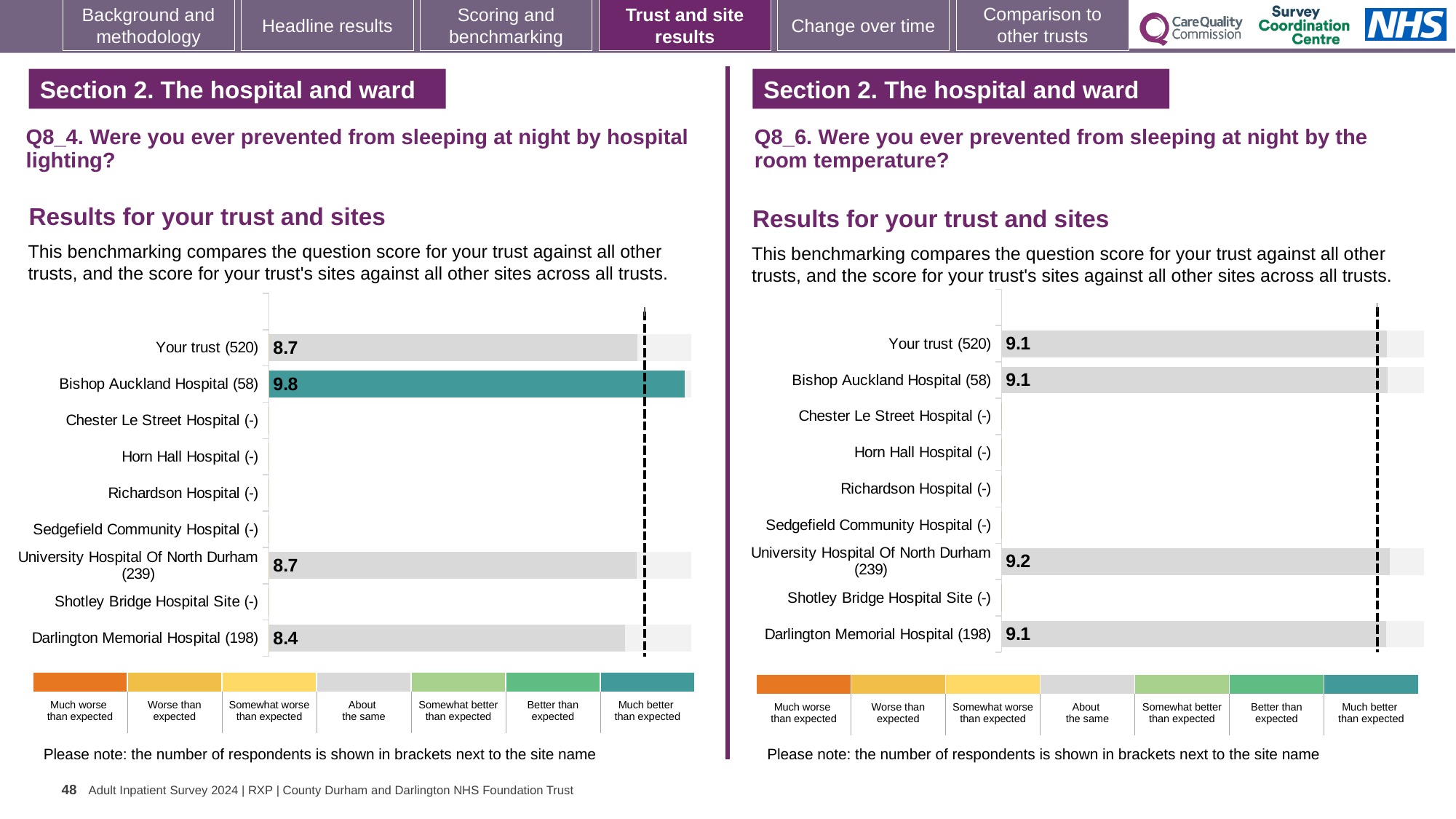
On the Q8_4 chart (hospital lighting), which site has the lowest score? Darlington Memorial Hospital What kind of chart is used on the Q8_6 chart (room temperature)? Bar chart On the Q8_4 chart (hospital lighting), what is the score for Bishop Auckland Hospital? 9.8 On the Q8_4 chart (hospital lighting), what is the score for Darlington Memorial Hospital? 8.4 On the Q8_6 chart (room temperature), what is the score for University Hospital Of North Durham? 9.2 On the Q8_6 chart (room temperature), what is the score for Your trust? 9.1 On the Q8_4 chart (hospital lighting), how many respondents are shown in brackets for Your trust? 520 On the Q8_4 chart (hospital lighting), how many sites (including Your trust) are listed on the vertical axis? 9 On the Q8_6 chart (room temperature), which site has the highest score? University Hospital Of North Durham On the Q8_6 chart (room temperature), what is the difference between the scores for University Hospital Of North Durham and Darlington Memorial Hospital? 0.1 On the Q8_4 chart (hospital lighting), what is the difference between the scores for Bishop Auckland Hospital and Darlington Memorial Hospital? 1.4 On the Q8_4 chart (hospital lighting), which site has the highest score? Bishop Auckland Hospital